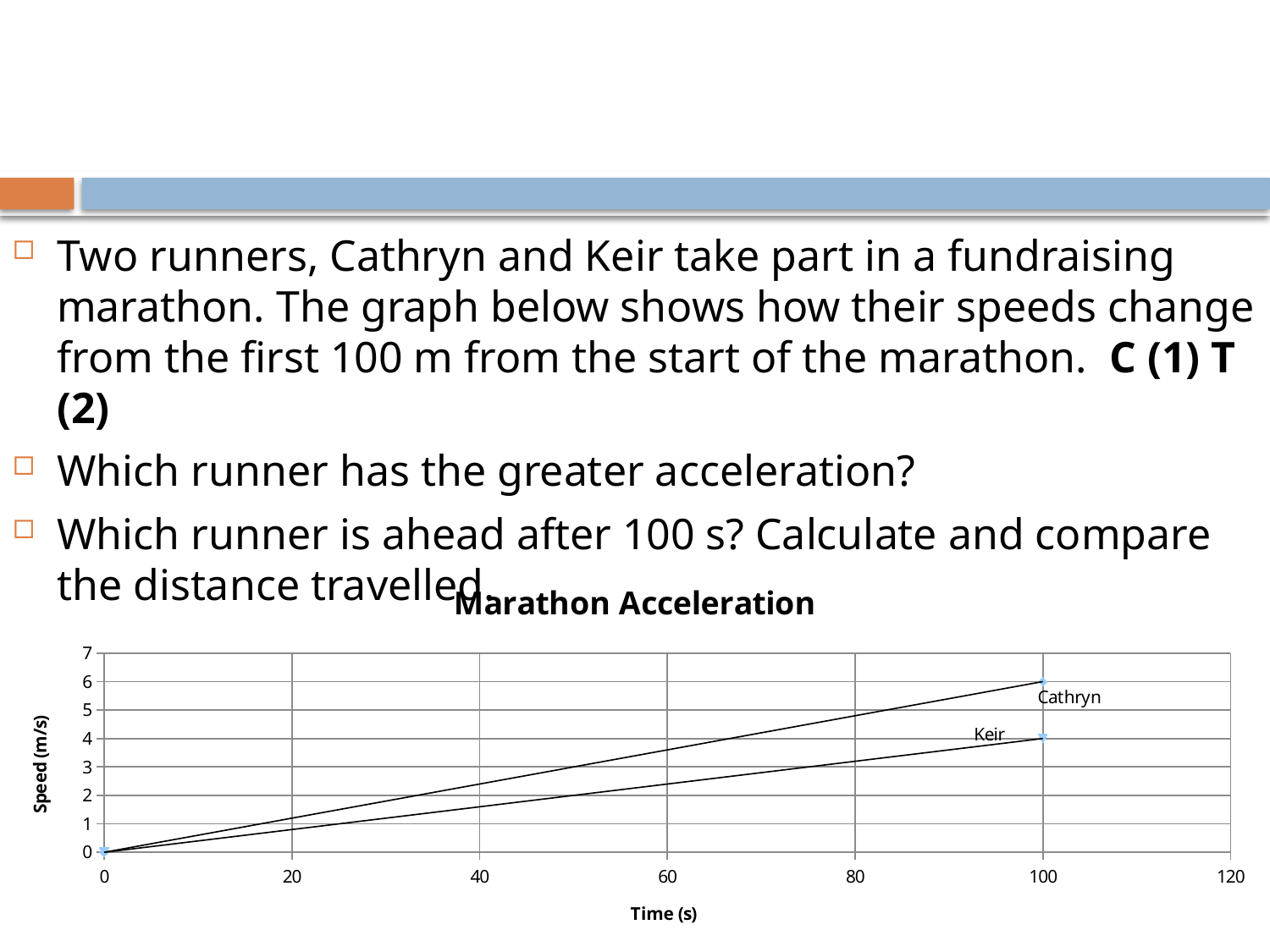
What is Keir's speed at 100 s? 4 Which runner has the higher speed at 100 s, Cathryn or Keir? Cathryn How many runners' lines are plotted on the chart? 2 What kind of chart is shown on the slide? line chart What is the title of the chart? Marathon Acceleration Is Keir's speed at 60 s greater or less than 3? less Do the runners' speeds rise or fall as time increases? rise What is Cathryn's speed at 100 s? 6 What is the difference between Cathryn's and Keir's speeds at 100 s? 2 What is the speed of both runners at time 0? 0 What is the label of the vertical axis of the chart? Speed (m/s) Is Cathryn's speed at 60 s greater or less than 3? greater